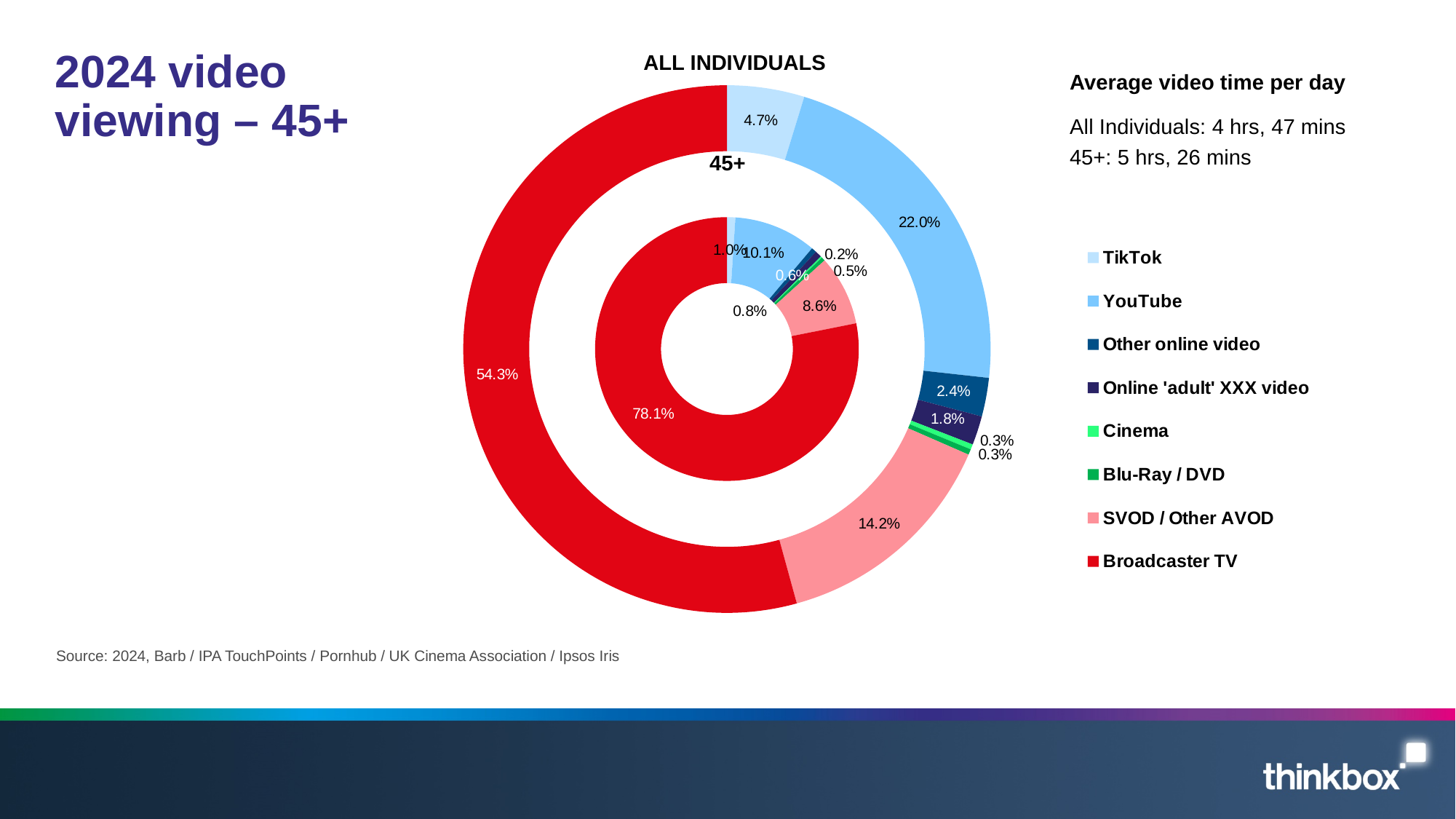
What share of video viewing does Broadcaster TV account for in the inner 45+ ring? 78.1% What share of video viewing does Broadcaster TV account for in the outer ALL INDIVIDUALS ring? 54.3% Which category has the largest share in the inner 45+ ring? Broadcaster TV What is the SVOD / Other AVOD share in the outer ALL INDIVIDUALS ring? 14.2% What is the TikTok share in the inner 45+ ring? 1.0% How many categories does the legend list? 8 What type of chart is shown on the slide? Doughnut chart What is the YouTube share in the inner 45+ ring? 10.1% Which colour represents Broadcaster TV in the chart? Red How many percentage points higher is the Broadcaster TV share for 45+ than for All Individuals? 23.8 percentage points In the outer ALL INDIVIDUALS ring, which is larger: the YouTube share or the SVOD / Other AVOD share? YouTube What is the YouTube share in the outer ALL INDIVIDUALS ring? 22.0%